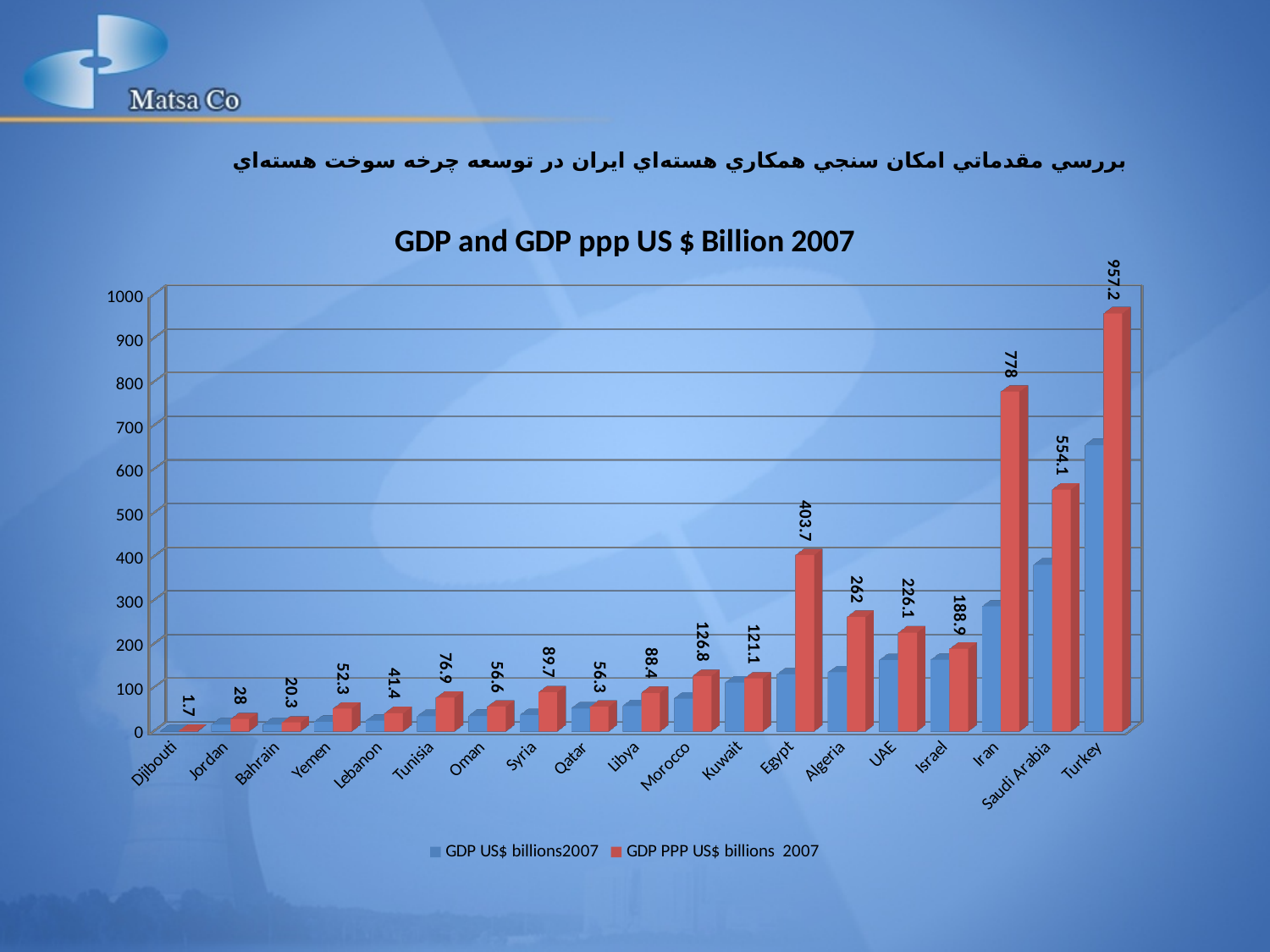
What is the GDP PPP US$ billions 2007 value for Morocco? 126.8 What is the difference between the GDP PPP US$ billions 2007 values for Turkey and Saudi Arabia? 403.1 What kind of chart is shown on the slide? Bar chart Is the GDP US$ billions2007 value for Turkey greater or less than 600? greater How many series does the legend list? 2 How many countries are shown on the x axis? 19 Is the GDP US$ billions2007 value for Iran greater or less than 400? less What is the GDP PPP US$ billions 2007 value for Iran? 778 Which has a larger GDP PPP US$ billions 2007 value, Algeria or UAE? Algeria Which country has the highest GDP PPP US$ billions 2007 value? Turkey What is the GDP PPP US$ billions 2007 value for Egypt? 403.7 Which country has the lowest GDP PPP US$ billions 2007 value? Djibouti